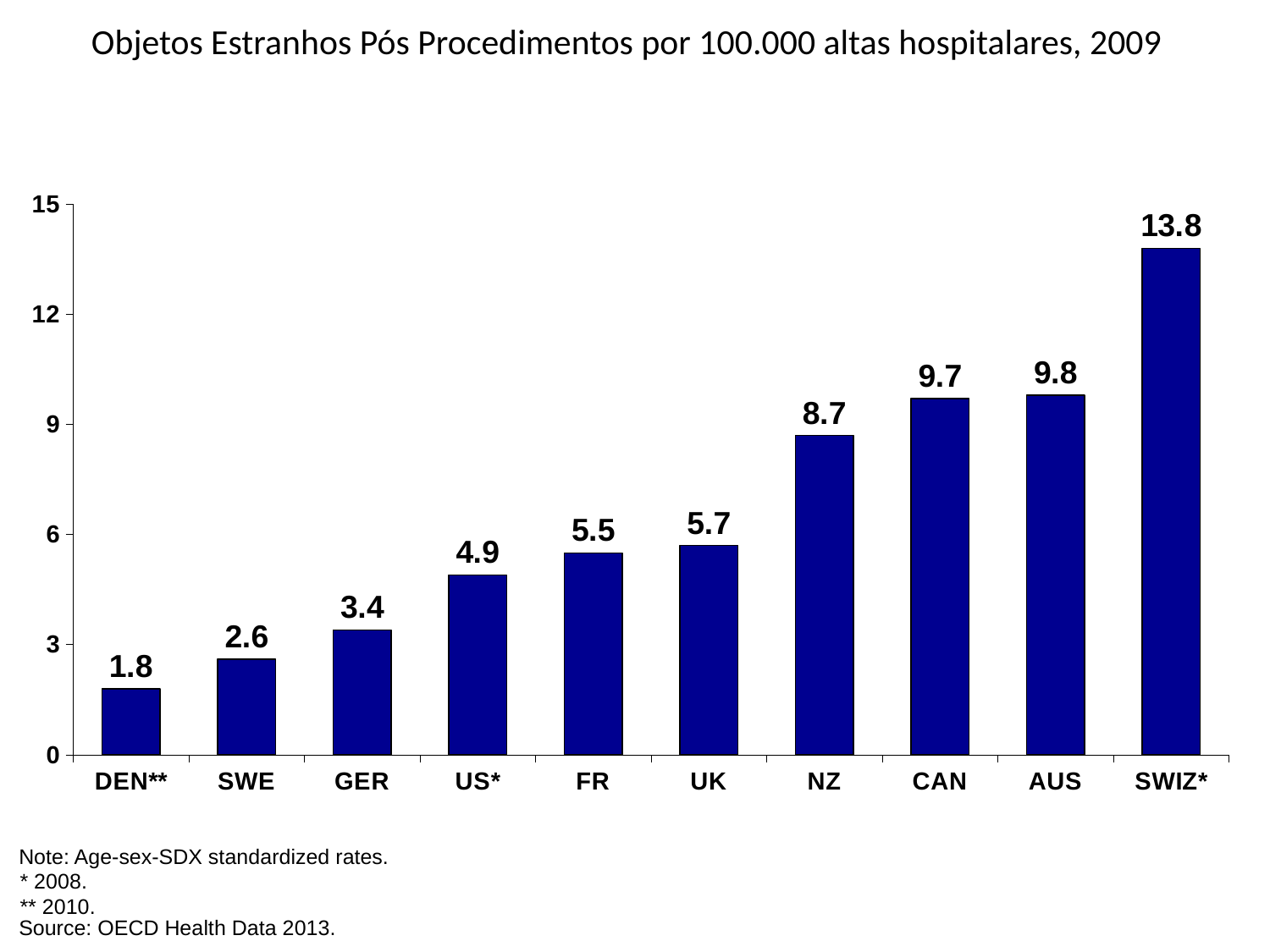
Which country has the lowest value? DEN** What is the difference between the values for SWIZ* and AUS? 4.0 How many countries are shown on the chart? 10 What is the value for SWIZ*? 13.8 What is the difference between the values for UK and FR? 0.2 Which country has the highest value? SWIZ* Which is larger, the value for CAN or the value for NZ? CAN Do the values rise or fall from left to right along the x axis? rise Is the value for US* greater or less than 6? less What kind of chart is this? bar chart What is the value for NZ? 8.7 What is the value for GER? 3.4